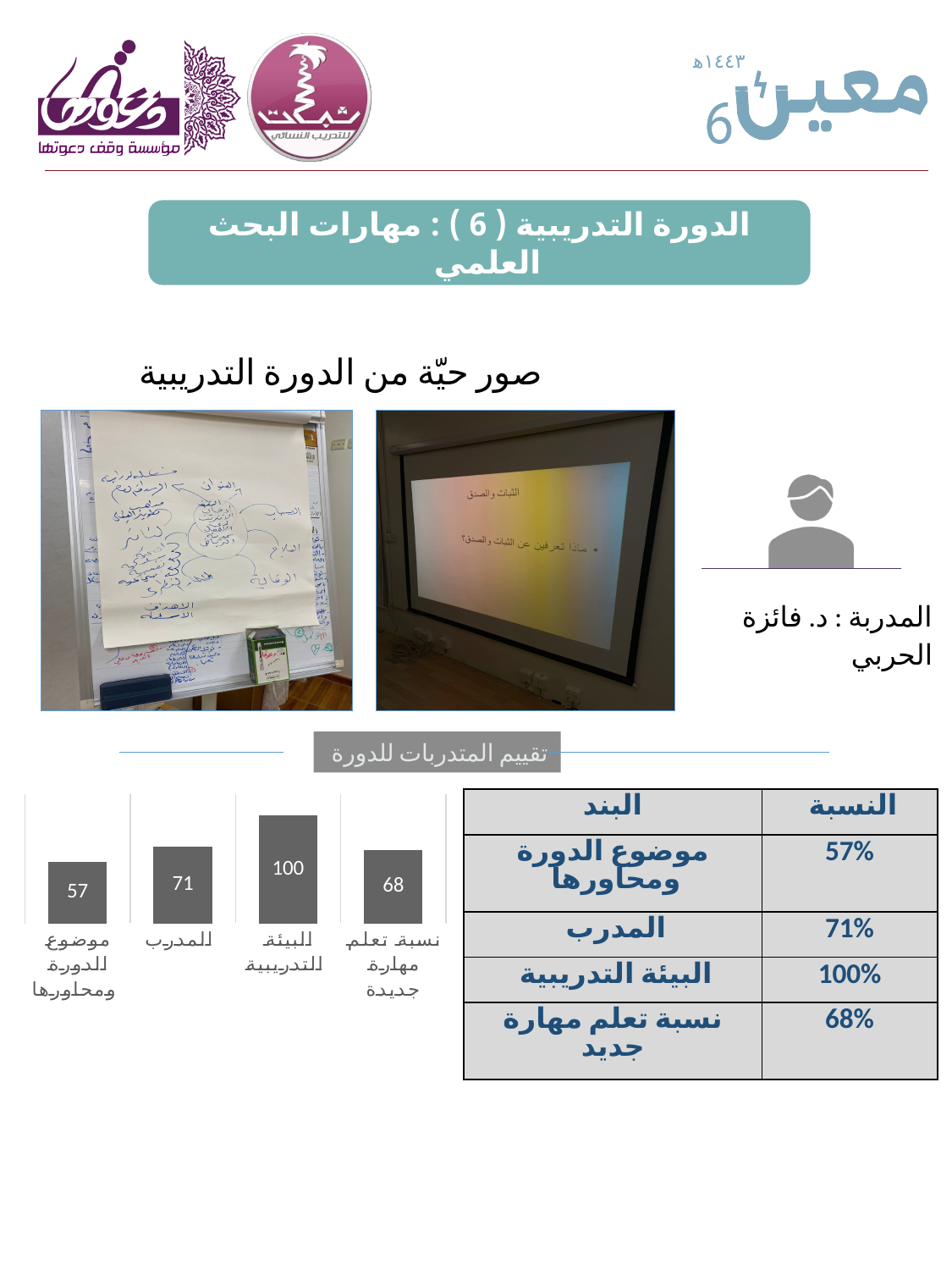
In the bar chart, what is the value for البيئة التدريبية? 100 In the bar chart, what is the value for نسبة تعلم مهارة جديدة? 68 In the bar chart, which is larger: the value for المدرب or the value for نسبة تعلم مهارة جديدة? المدرب Which category has the highest value in the bar chart? البيئة التدريبية In the bar chart, what is the value for المدرب? 71 In the bar chart, what is the difference between the values for نسبة تعلم مهارة جديدة and موضوع الدورة ومحاورها? 11 How many bars does the chart at the bottom left of the slide have? 4 In the bar chart, what is the difference between the values for البيئة التدريبية and المدرب? 29 What colour are the bars in the bar chart? grey What type of chart is shown at the bottom left of the slide? bar chart In the bar chart, what is the value for موضوع الدورة ومحاورها? 57 Which category has the lowest value in the bar chart? موضوع الدورة ومحاورها